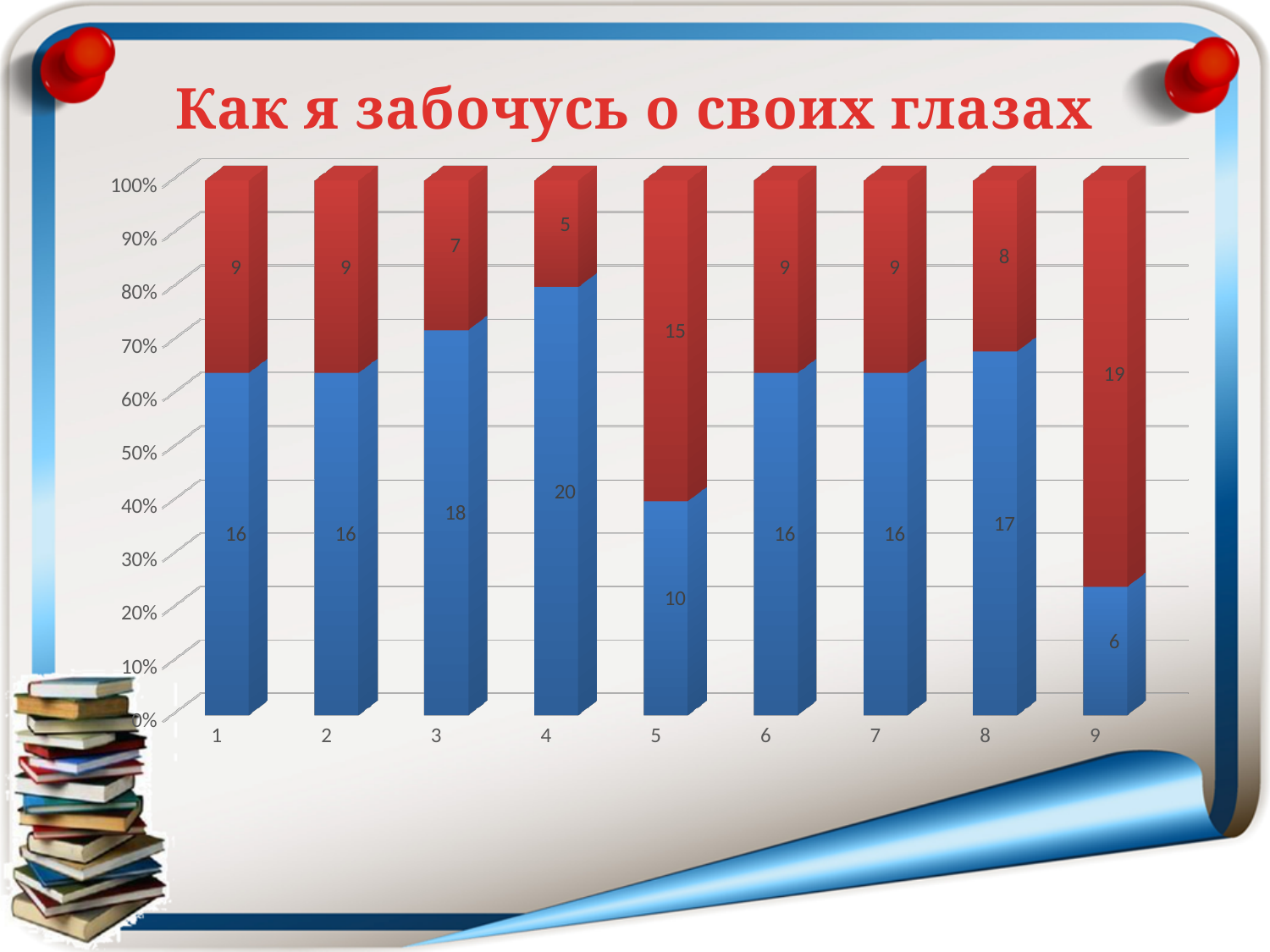
Which category has the lowest blue segment value? 9 What is the title of the chart? Как я забочусь о своих глазах What is the value of the blue segment for category 5? 10 What is the value of the blue segment for category 4? 20 What kind of chart is shown on the slide? stacked bar chart What is the difference between the red and blue segment values for category 9? 13 What is the value of the red segment for category 9? 19 How many categories are shown on the x axis? 9 Which is larger for category 5, the blue segment or the red segment? red segment What is the total of the blue and red segments for category 1? 25 Which category has the lowest red segment value? 4 Which category has the highest blue segment value? 4